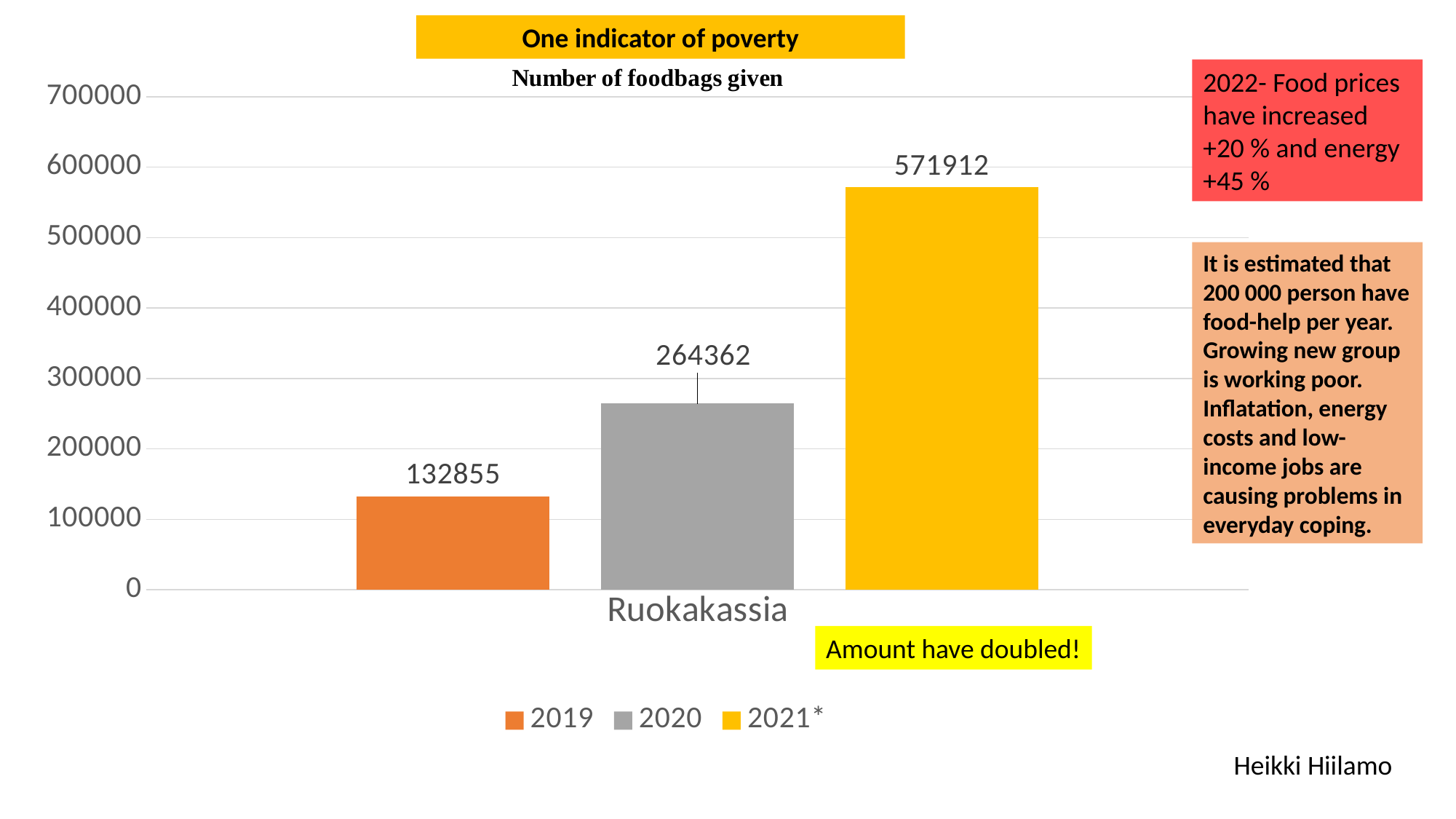
What kind of chart is shown on the slide? bar chart Which year has the lowest number of foodbags given? 2019 What is the difference between the number of foodbags given in 2021* and in 2020? 307550 What is the difference between the number of foodbags given in 2020 and in 2019? 131507 Is the value for 2021* greater or less than 500000? greater Which is larger, the number of foodbags given in 2020 or in 2021*? 2021* What is the number of foodbags given for 2020? 264362 Which year has the highest number of foodbags given? 2021* What is the number of foodbags given for 2021*? 571912 What is the number of foodbags given for 2019? 132855 How many series does the legend list? 3 What is the title of the chart? Number of foodbags given